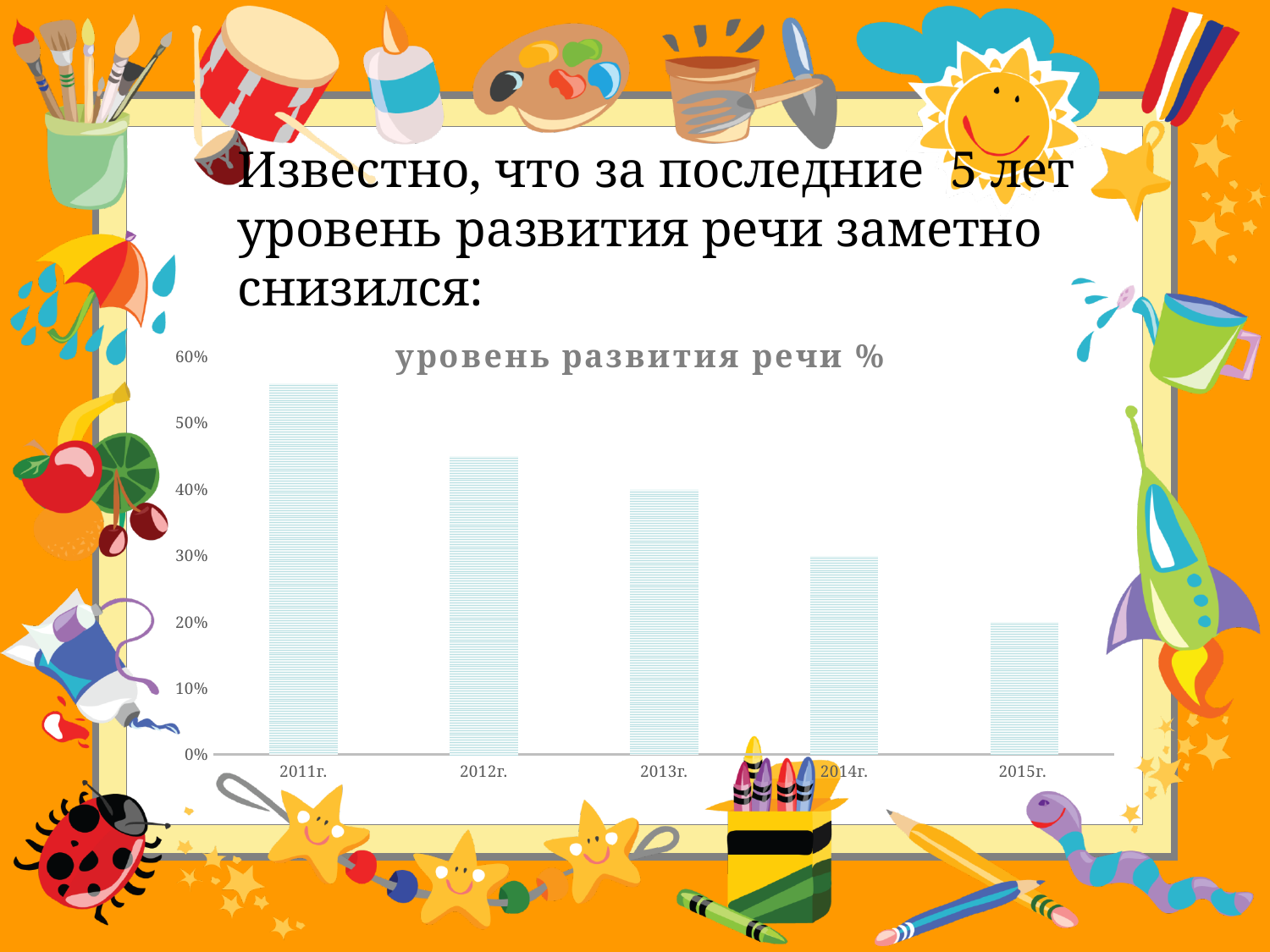
What is the difference between the values for 2013г. and 2015г.? 20% Do the values rise or fall from 2011г. to 2015г.? fall Which year has the lowest value in the chart? 2015г. What is the value for 2015г.? 20% What is the title of the chart? уровень развития речи % Is the value for 2011г. greater or less than 50%? greater Is the value for 2012г. greater or less than 40%? greater How many categories (years) are shown on the x axis of the chart? 5 What kind of chart is shown on the slide? bar chart What is the value for 2013г.? 40% What is the value for 2014г.? 30% Which year has the highest value in the chart? 2011г.